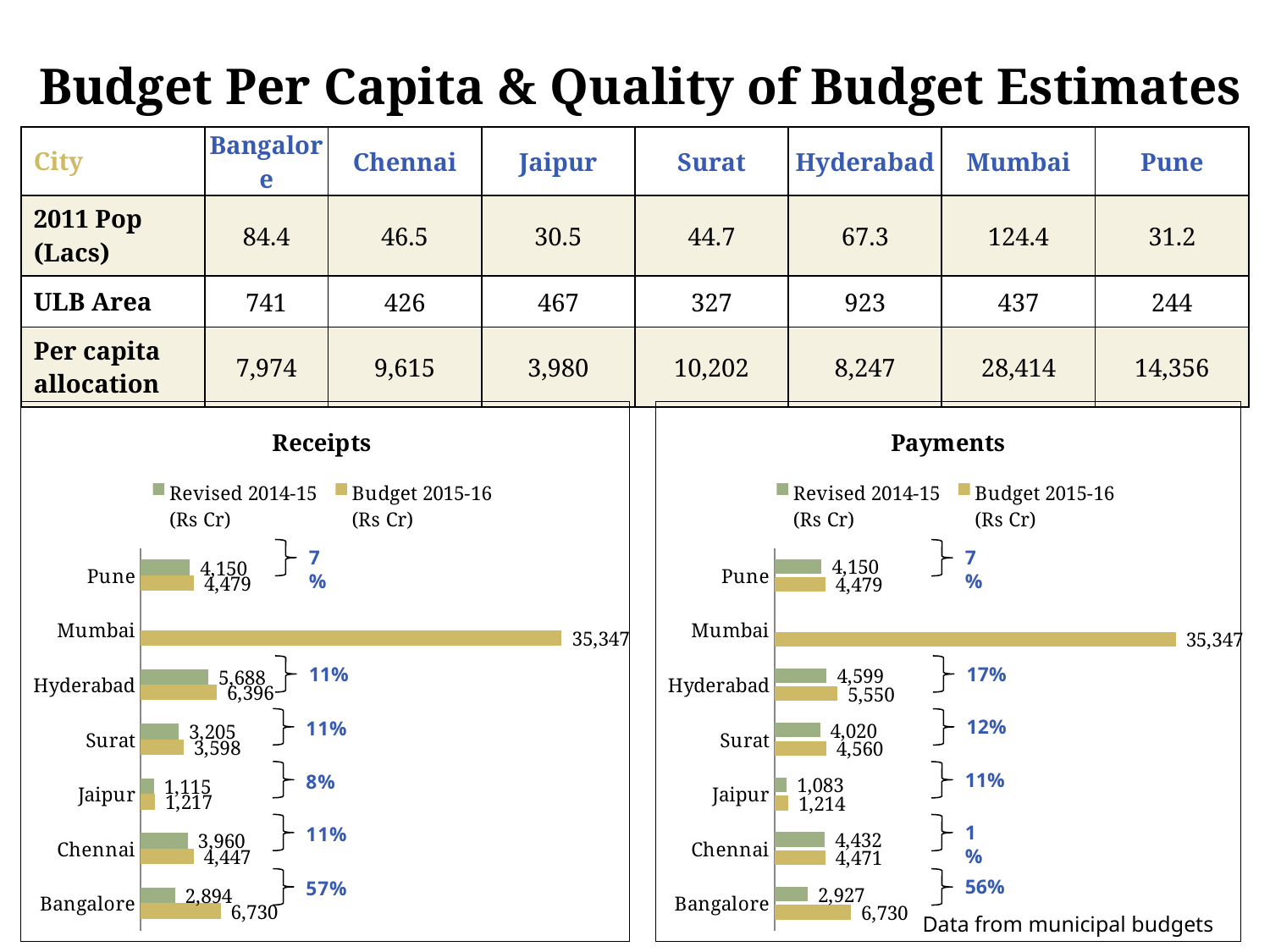
In the Receipts chart, what is the Revised 2014-15 (Rs Cr) value for Bangalore? 2,894 How many cities are shown in the Payments chart? 7 In the Receipts chart, what is the Budget 2015-16 (Rs Cr) value for Hyderabad? 6,396 In the Receipts chart, what is the difference between the Budget 2015-16 and Revised 2014-15 values for Bangalore? 3,836 In the Receipts chart, which city has the highest Budget 2015-16 (Rs Cr) value? Mumbai In the Payments chart, which city has the lowest Budget 2015-16 (Rs Cr) value? Jaipur In the Payments chart, what is the Budget 2015-16 (Rs Cr) value for Surat? 4,560 In the Payments chart, what is the difference between the Budget 2015-16 and Revised 2014-15 values for Hyderabad? 951 How many series does the legend of the Receipts chart list? 2 In the Receipts chart, which is larger: the Revised 2014-15 value for Hyderabad or the Revised 2014-15 value for Chennai? Hyderabad What type of chart is the Payments chart? Bar chart In the Payments chart, what is the Revised 2014-15 (Rs Cr) value for Jaipur? 1,083